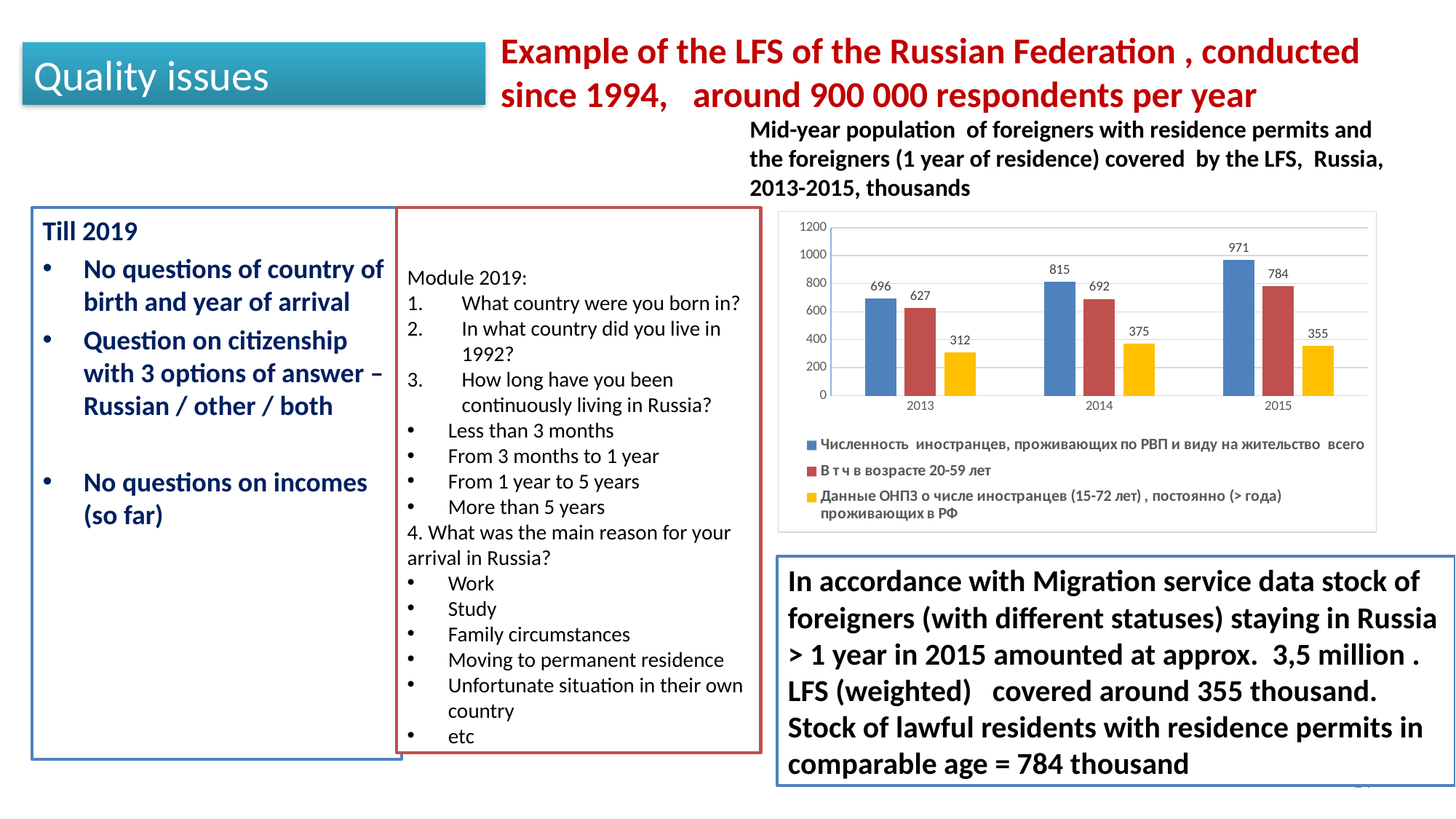
Does the blue series (total foreigners with residence permits) rise or fall from 2013 to 2015? rise What is the difference between the blue and red series values in 2014? 123 Which is larger: the yellow series value in 2014 or in 2015? 2014 What is the value of the red series (aged 20-59) for 2013? 627 How many years are shown on the x axis of the chart? 3 What is the value of the yellow series (LFS data on foreigners residing > 1 year) for 2014? 375 Is the blue series value for 2014 greater or less than 800? greater What is the value of the blue series (total foreigners with residence permits) for 2015? 971 How many series does the chart legend list? 3 In which year is the blue series (total foreigners with residence permits) highest? 2015 In which year is the yellow series (LFS data) lowest? 2013 What kind of chart is shown on the slide? bar chart